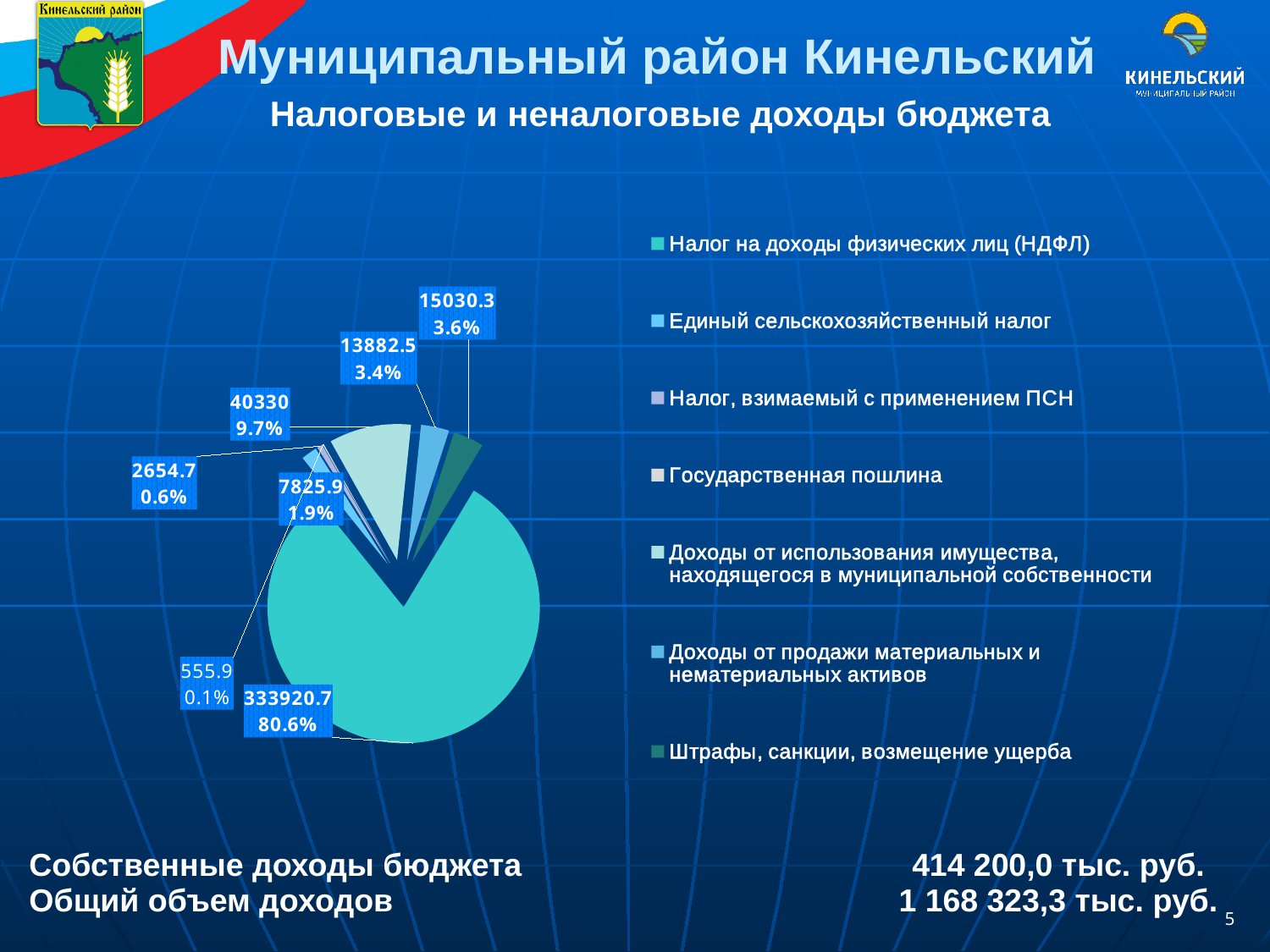
Which category has the largest slice in the pie chart? Налог на доходы физических лиц (НДФЛ) What value is shown for Налог на доходы физических лиц (НДФЛ) in the pie chart? 333920.7 What share of the pie does Налог на доходы физических лиц (НДФЛ) account for? 80.6% What is the smallest value labelled on the pie chart? 555.9 What is the subtitle of the chart slide? Налоговые и неналоговые доходы бюджета What value is labelled for Доходы от использования имущества, находящегося в муниципальной собственности? 40330 What percentage is shown for the smallest slice of the pie chart? 0.1% Which is larger: the slice labelled 15030.3 or the slice labelled 13882.5? 15030.3 What share of the pie is labelled for Доходы от использования имущества, находящегося в муниципальной собственности? 9.7% What kind of chart is shown on the slide? pie chart What is the difference between the slice labelled 15030.3 and the slice labelled 13882.5? 1147.8 How many categories does the legend of the pie chart list? 7